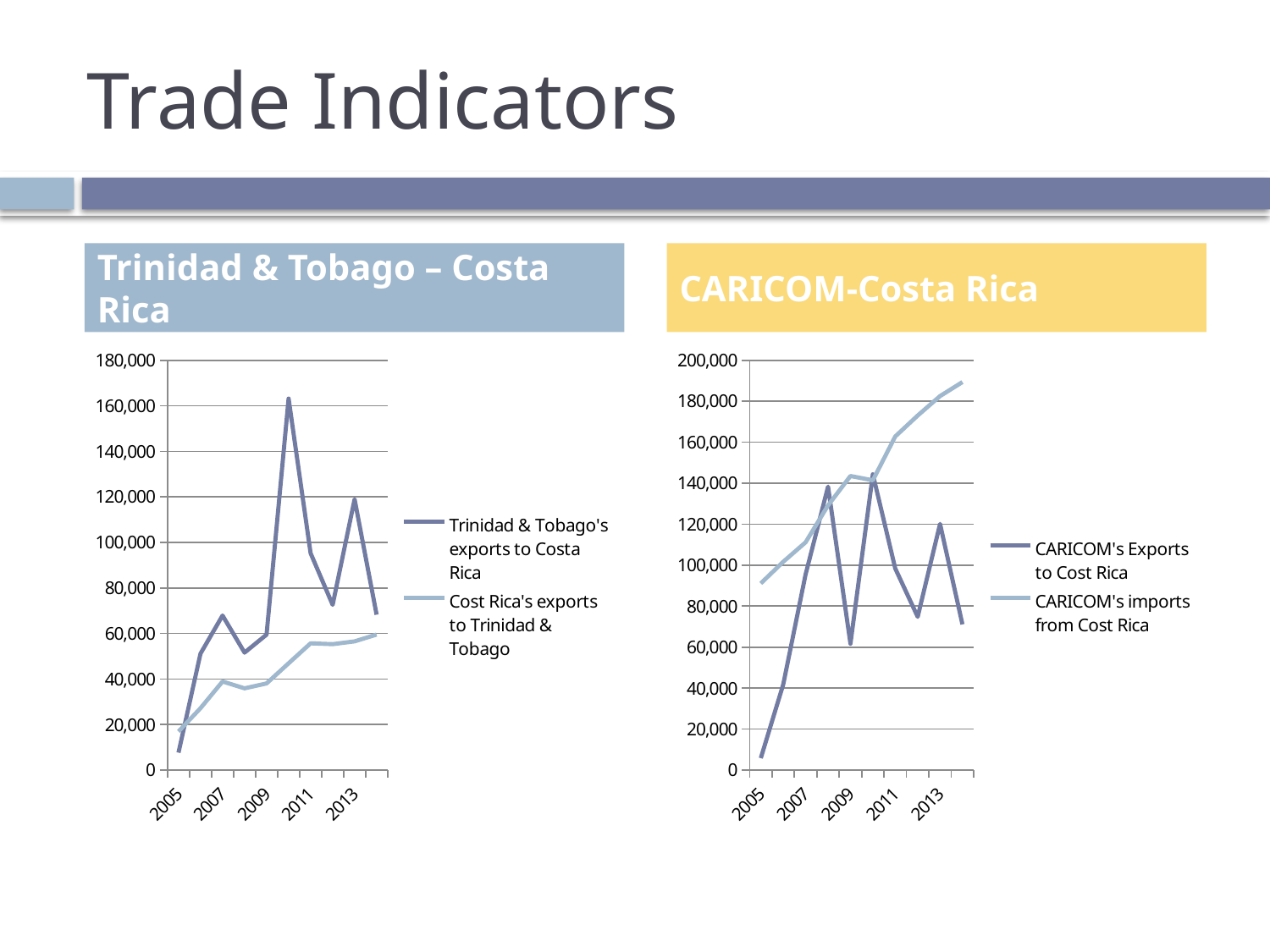
In the CARICOM-Costa Rica chart, which series has the larger value in 2014: CARICOM's Exports to Cost Rica or CARICOM's imports from Cost Rica? CARICOM's imports from Cost Rica In the CARICOM-Costa Rica chart, do CARICOM's imports from Cost Rica rise or fall from 2005 to 2014? rise In the CARICOM-Costa Rica chart, is the value for CARICOM's imports from Cost Rica in 2014 greater or less than 180,000? greater In the Trinidad & Tobago – Costa Rica chart, in which year is Trinidad & Tobago's exports to Costa Rica highest? 2010 What type of chart is the Trinidad & Tobago – Costa Rica chart on the left? Line chart In the Trinidad & Tobago – Costa Rica chart, which series has the larger value in 2010: Trinidad & Tobago's exports to Costa Rica or Cost Rica's exports to Trinidad & Tobago? Trinidad & Tobago's exports to Costa Rica In the Trinidad & Tobago – Costa Rica chart, do Cost Rica's exports to Trinidad & Tobago generally rise or fall from 2005 to 2014? rise In the Trinidad & Tobago – Costa Rica chart, is the value for Cost Rica's exports to Trinidad & Tobago in 2005 greater or less than 40,000? less In the CARICOM-Costa Rica chart, is the value for CARICOM's Exports to Cost Rica in 2005 greater or less than 20,000? less How many series does the legend of the CARICOM-Costa Rica chart list? 2 How many series does the legend of the Trinidad & Tobago – Costa Rica chart list? 2